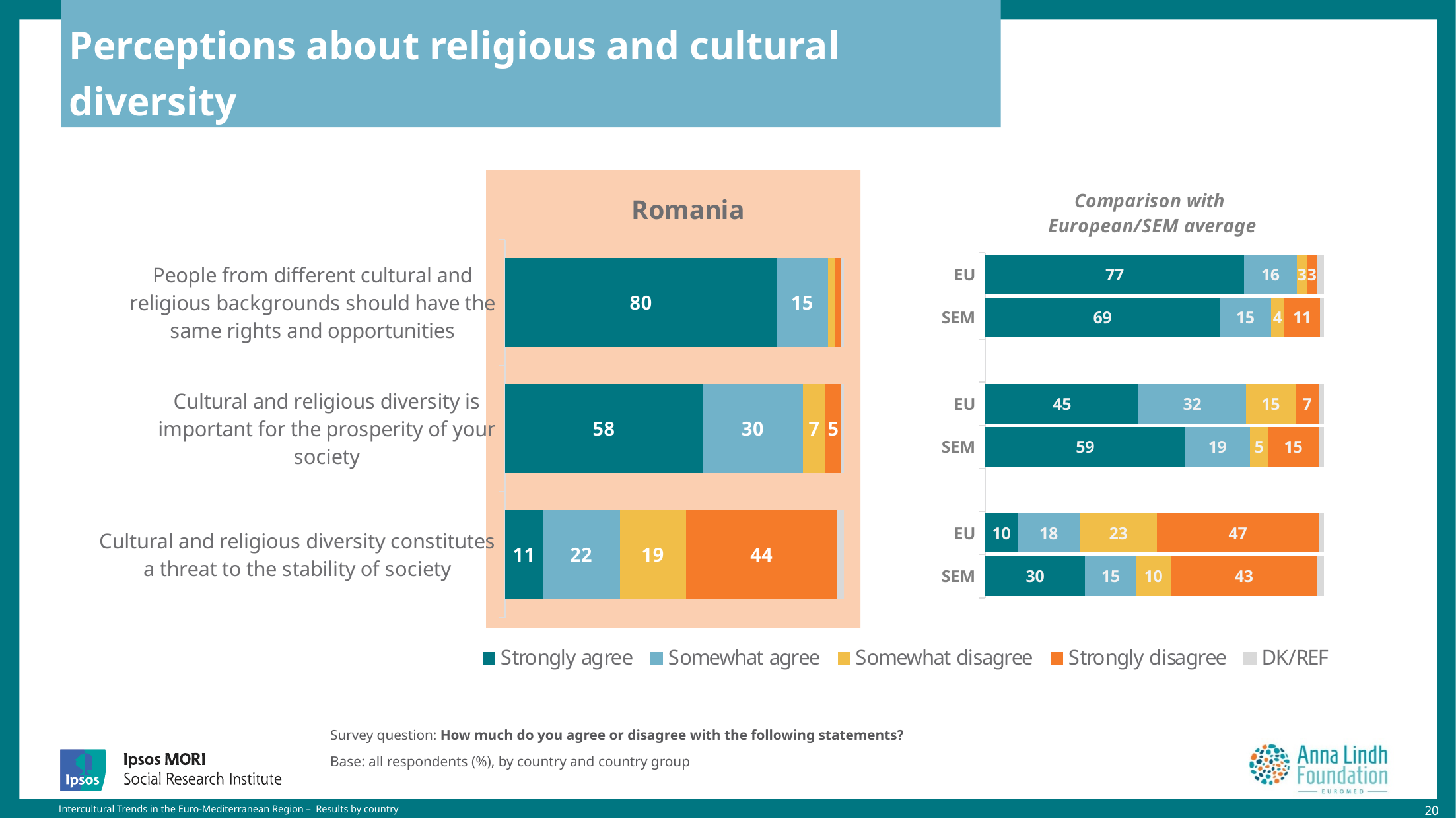
What kind of chart is the Romania chart? Stacked bar chart In the Romania chart, which statement has the highest Strongly agree value? People from different cultural and religious backgrounds should have the same rights and opportunities What is the title of the chart on the right of the slide? Comparison with European/SEM average In the Comparison with European/SEM average chart, for the statement that diversity constitutes a threat, is the Strongly agree value larger for EU or SEM? SEM In the Comparison with European/SEM average chart, what is the difference between the SEM and EU Strongly disagree values for the prosperity statement? 8 In the Romania chart, what is the difference between the Somewhat agree values for the prosperity statement and the same rights statement? 15 How many statements are shown in the Romania chart? 3 In the Comparison with European/SEM average chart, what is the EU Strongly agree value for the same rights and opportunities statement? 77 In the Comparison with European/SEM average chart, what is the SEM Strongly disagree value for the statement that diversity constitutes a threat to the stability of society? 43 In the Romania chart, what percentage strongly agree that people from different cultural and religious backgrounds should have the same rights and opportunities? 80 In the Romania chart, what percentage strongly disagree that cultural and religious diversity constitutes a threat to the stability of society? 44 How many series does the legend list? 5